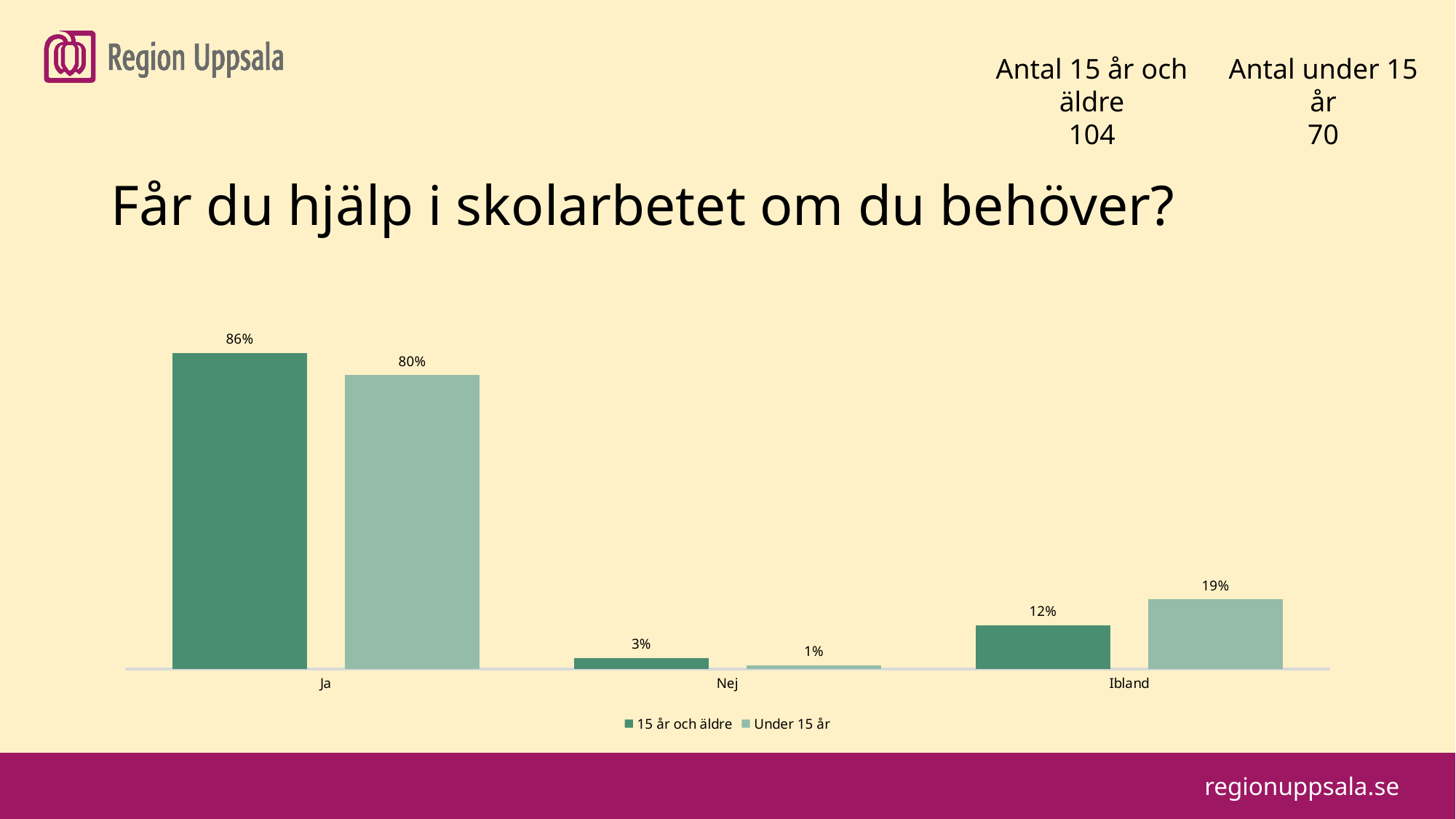
What is the value for "Ja" in the "Under 15 år" series? 80% Which category has the lowest value in the "Under 15 år" series? Nej What is the value for "Ibland" in the "Under 15 år" series? 19% Which category has the highest value in the "15 år och äldre" series? Ja What is the difference between the "15 år och äldre" and "Under 15 år" values for "Ja"? 6 percentage points What is the value for "Ja" in the "15 år och äldre" series? 86% What is the difference between the "Under 15 år" and "15 år och äldre" values for "Ibland"? 7 percentage points How many categories are shown on the x axis? 3 For "Ibland", which series has the larger value: "15 år och äldre" or "Under 15 år"? Under 15 år How many series does the legend list? 2 What is the value for "Nej" in the "15 år och äldre" series? 3% What kind of chart is shown on the slide? Bar chart